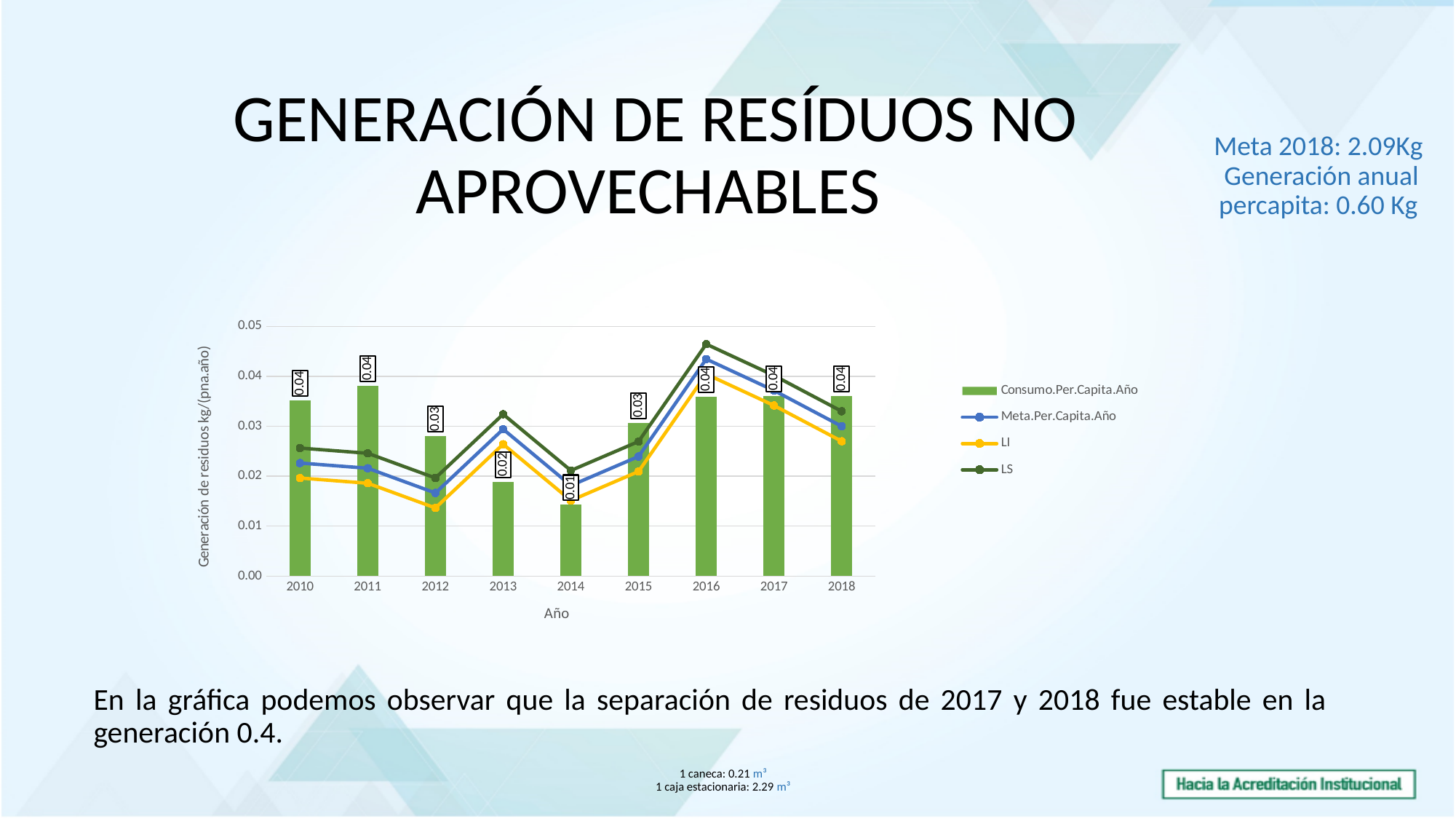
How many years are shown on the x axis of the chart? 9 Which year has the larger Consumo.Per.Capita.Año bar, 2013 or 2015? 2015 How many series does the chart legend list? 4 Which year has the lowest Consumo.Per.Capita.Año bar? 2014 What is the label of the x axis of the chart? Año What kind of chart is shown on the slide? Combined bar and line chart What is the data label on the Consumo.Per.Capita.Año bar for 2018? 0.04 What is the data label on the Consumo.Per.Capita.Año bar for 2013? 0.02 What is the data label on the Consumo.Per.Capita.Año bar for 2014? 0.01 What is the difference between the labelled Consumo.Per.Capita.Año values for 2011 and 2014? 0.03 Is the LI value for 2014 greater or less than 0.02? less Is the LS value for 2016 greater or less than 0.04? greater